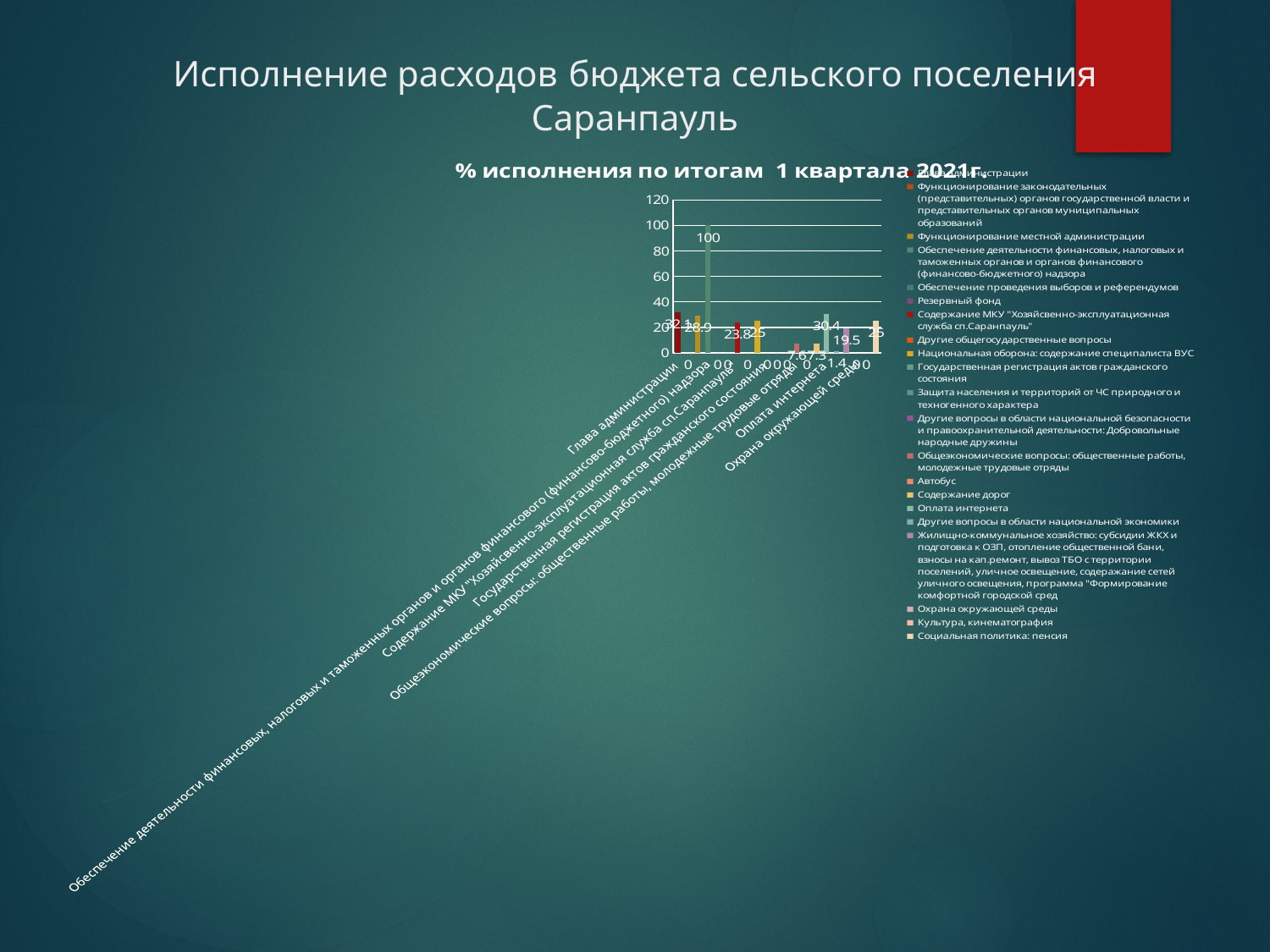
Is the value labelled 30.4 greater or less than 40? less What is the difference between the bar labelled 100 and the bar labelled 30.4? 69.6 What is the title of the chart? % исполнения по итогам 1 квартала 2021г. How many series does the legend list? 21 What kind of chart is shown on the slide? bar chart What is the maximum value shown on the vertical axis? 120 Which is larger, the bar labelled 100 or the bar labelled 30.4? 100 Is the tallest bar on the chart greater or less than 80? greater What is the highest value labelled on the chart? 100